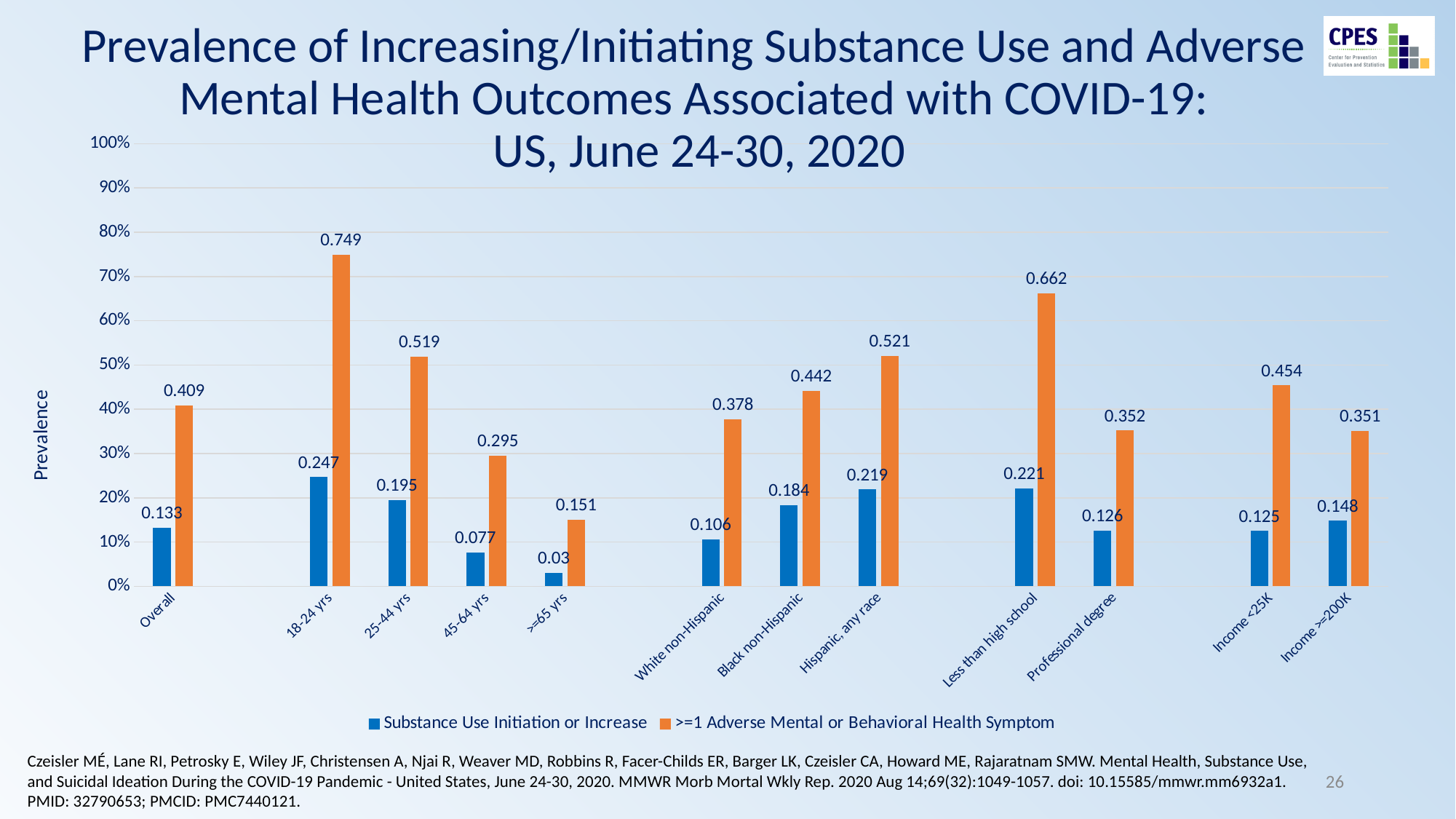
Which is larger for Substance Use Initiation or Increase: Black non-Hispanic or Hispanic, any race? Hispanic, any race What is the value for Substance Use Initiation or Increase for Income >=200K? 0.148 What is the difference between the >=1 Adverse Mental or Behavioral Health Symptom value and the Substance Use Initiation or Increase value for 18-24 yrs? 0.502 How many series does the legend list? 2 Which category has the lowest value for >=1 Adverse Mental or Behavioral Health Symptom? >=65 yrs What is the value for >=1 Adverse Mental or Behavioral Health Symptom for 18-24 yrs? 0.749 What is the value for >=1 Adverse Mental or Behavioral Health Symptom for Less than high school? 0.662 Which category has the highest value for Substance Use Initiation or Increase? 18-24 yrs Is the >=1 Adverse Mental or Behavioral Health Symptom value for Income <25K greater or less than 40%? greater What kind of chart is shown on the slide? Bar chart What is the value for Substance Use Initiation or Increase in the Overall category? 0.133 How many categories are shown on the x axis? 12